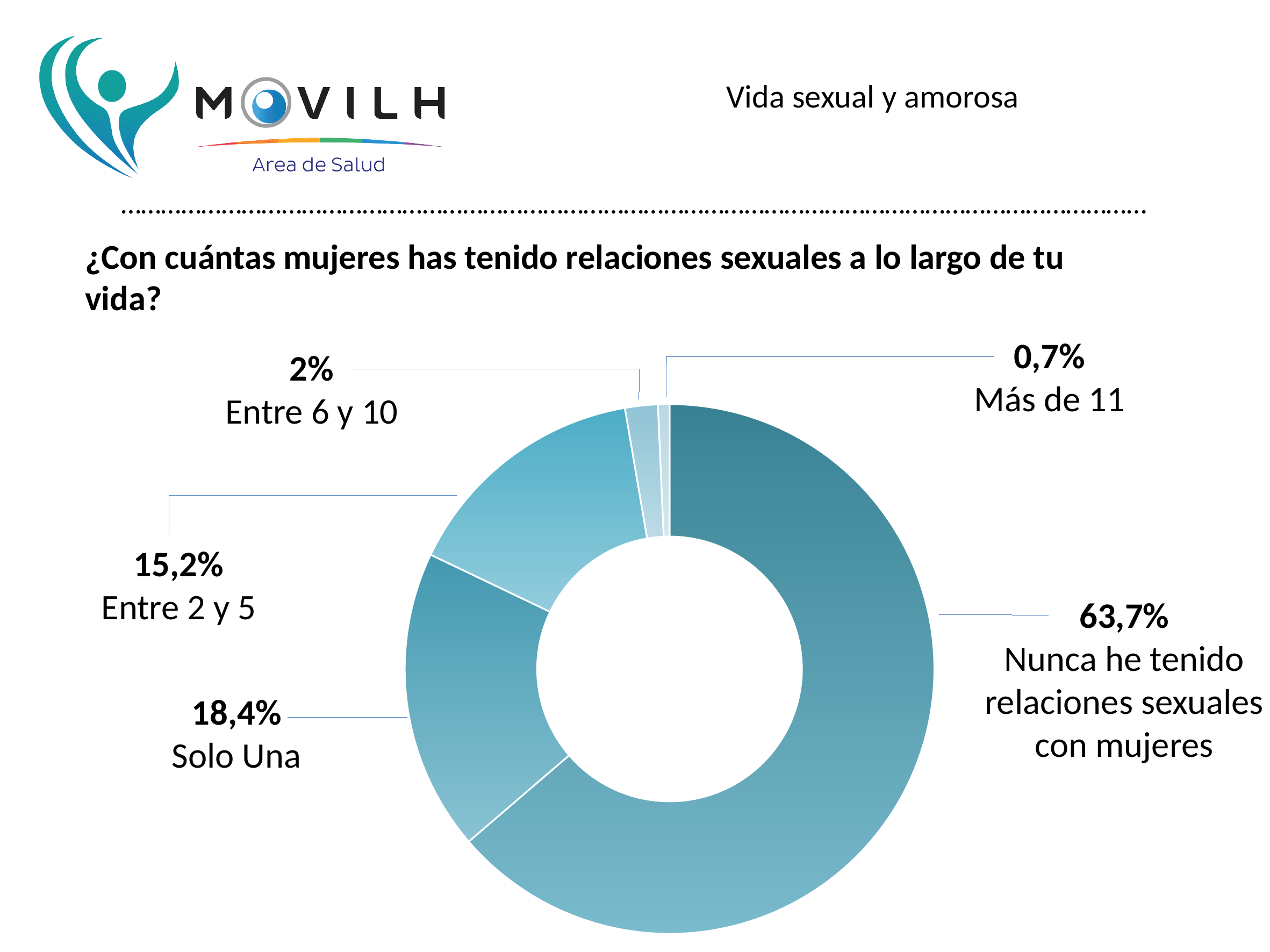
What kind of chart is shown on the slide? Pie chart (donut) Which category has the largest share of the chart? Nunca he tenido relaciones sexuales con mujeres What percentage of respondents answered 'Entre 6 y 10'? 2% What question does the chart answer, according to the title above it? ¿Con cuántas mujeres has tenido relaciones sexuales a lo largo de tu vida? How many categories are shown in the chart? 5 What percentage of respondents answered 'Más de 11'? 0,7% What percentage of respondents answered 'Nunca he tenido relaciones sexuales con mujeres'? 63,7% Which is larger, the share for 'Entre 6 y 10' or the share for 'Más de 11'? Entre 6 y 10 What percentage of respondents answered 'Entre 2 y 5'? 15,2% What is the difference in percentage points between 'Solo Una' and 'Entre 2 y 5'? 3,2 Which category has the smallest share of the chart? Más de 11 What percentage of respondents answered 'Solo Una'? 18,4%